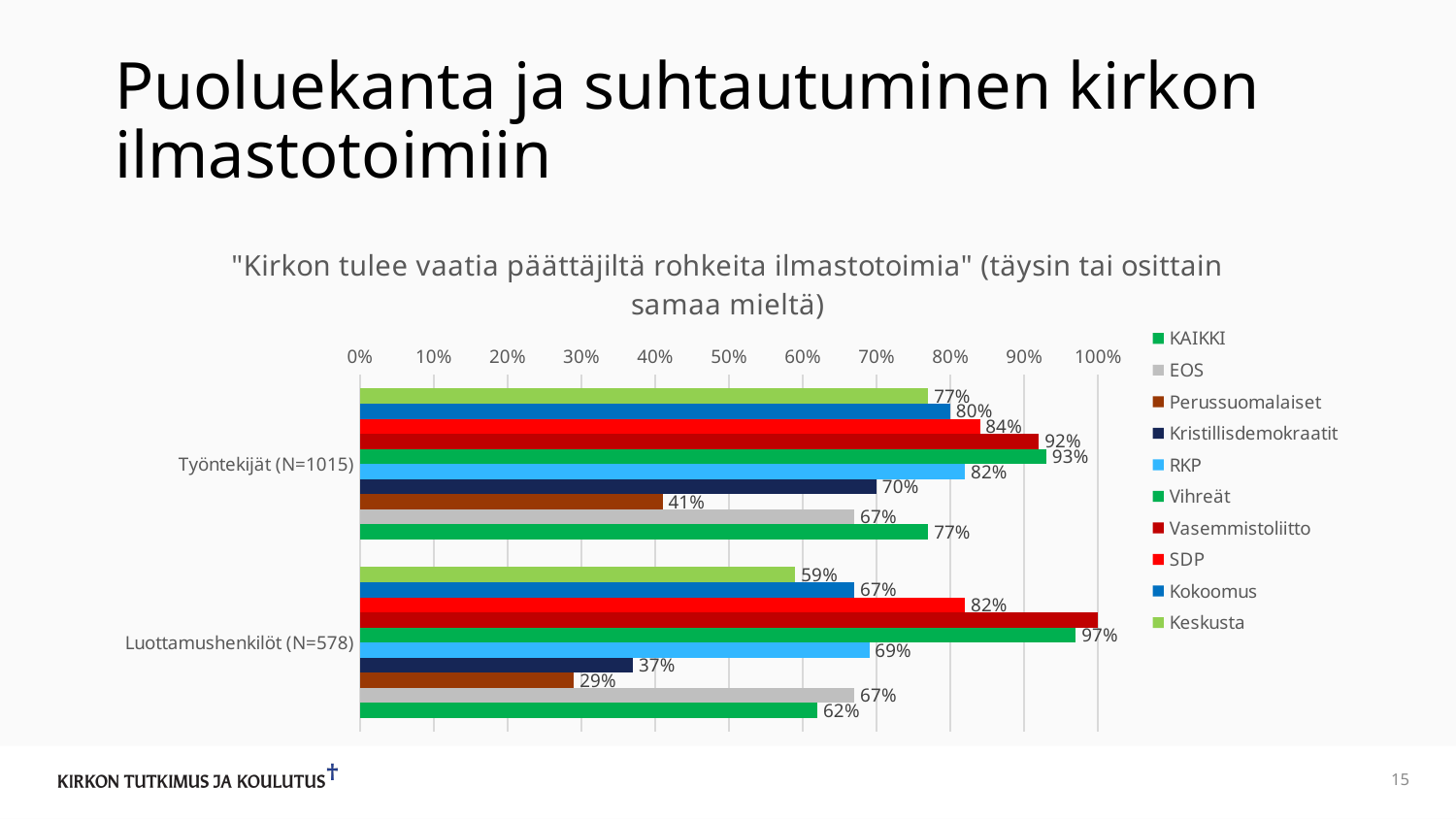
How many respondent groups (categories) are shown on the vertical axis? 2 Which party has the highest value in the Työntekijät (N=1015) group? Vihreät Is the Kokoomus value higher for Työntekijät (N=1015) or for Luottamushenkilöt (N=578)? Työntekijät (N=1015) How many series does the legend list? 10 What percentage of Perussuomalaiset supporters among Työntekijät (N=1015) agree that the church should demand bold climate action? 41% What is the difference between the SDP value for Työntekijät (N=1015) and for Luottamushenkilöt (N=578)? 2 percentage points Is the value for Vasemmistoliitto in the Luottamushenkilöt (N=578) group greater or less than 90%? greater Which party has the lowest value in the Luottamushenkilöt (N=578) group? Perussuomalaiset What is the value for Vihreät in the Luottamushenkilöt (N=578) group? 97% What kind of chart is shown on the slide? Bar chart What is the value for Kristillisdemokraatit in the Luottamushenkilöt (N=578) group? 37% What is the value for KAIKKI in the Työntekijät (N=1015) group? 77%